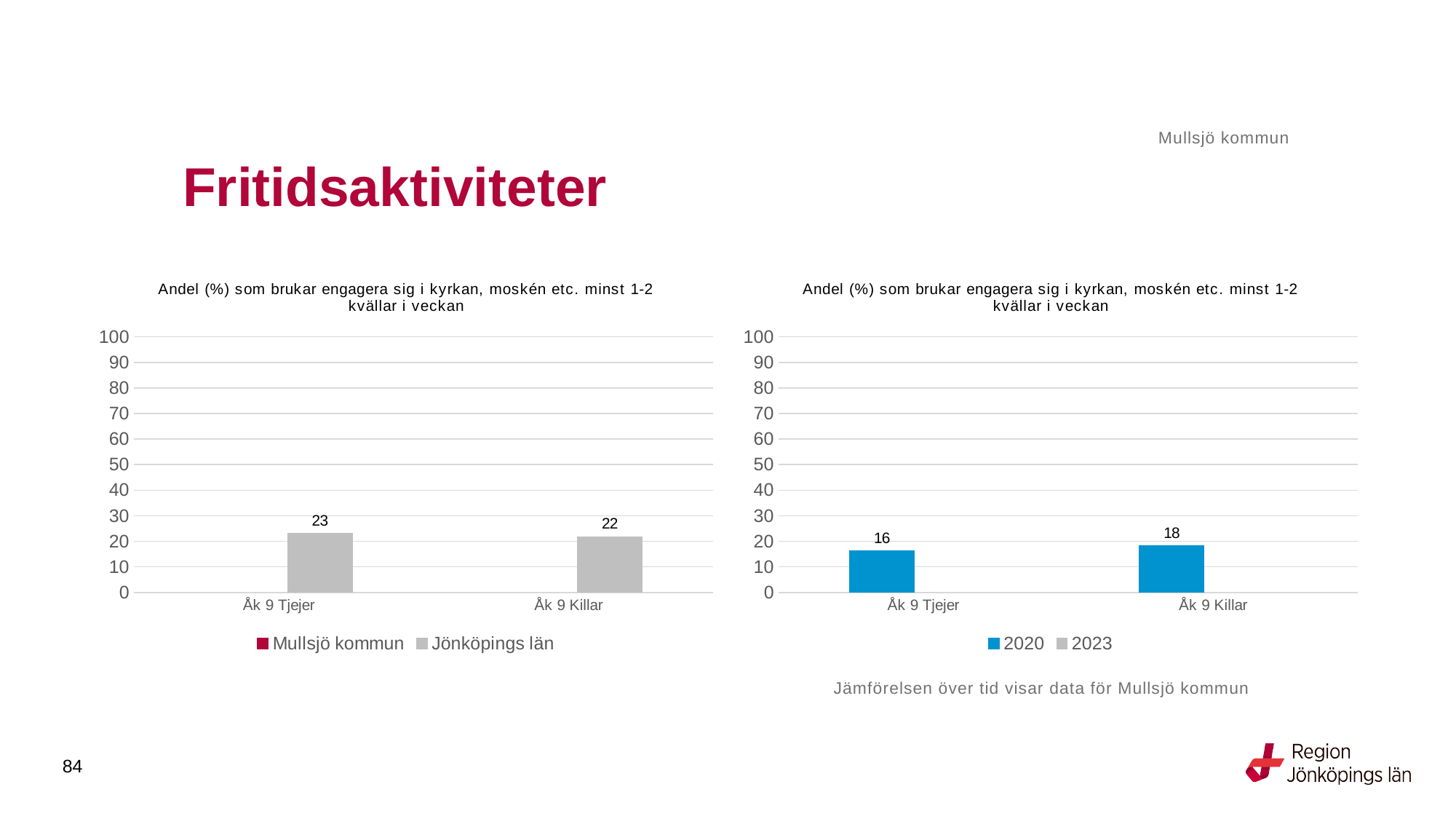
In the right chart, what is the 2020 value for Åk 9 Tjejer? 16 How many series does the legend of the left chart list? 2 In the right chart, what is the difference between the 2020 values for Åk 9 Killar and Åk 9 Tjejer? 2 In the left chart, what is the value for Jönköpings län for Åk 9 Tjejer? 23 In the left chart, what is the value for Jönköpings län for Åk 9 Killar? 22 What kind of chart is the right chart? bar chart In the right chart, which category has the higher 2020 value, Åk 9 Tjejer or Åk 9 Killar? Åk 9 Killar In the left chart, what is the difference between the Jönköpings län values for Åk 9 Tjejer and Åk 9 Killar? 1 How many categories are shown on the x axis of the right chart? 2 Which series are listed in the legend of the right chart? 2020 and 2023 In the left chart, is the Jönköpings län value for Åk 9 Tjejer greater or less than 30? less In the right chart, what is the 2020 value for Åk 9 Killar? 18